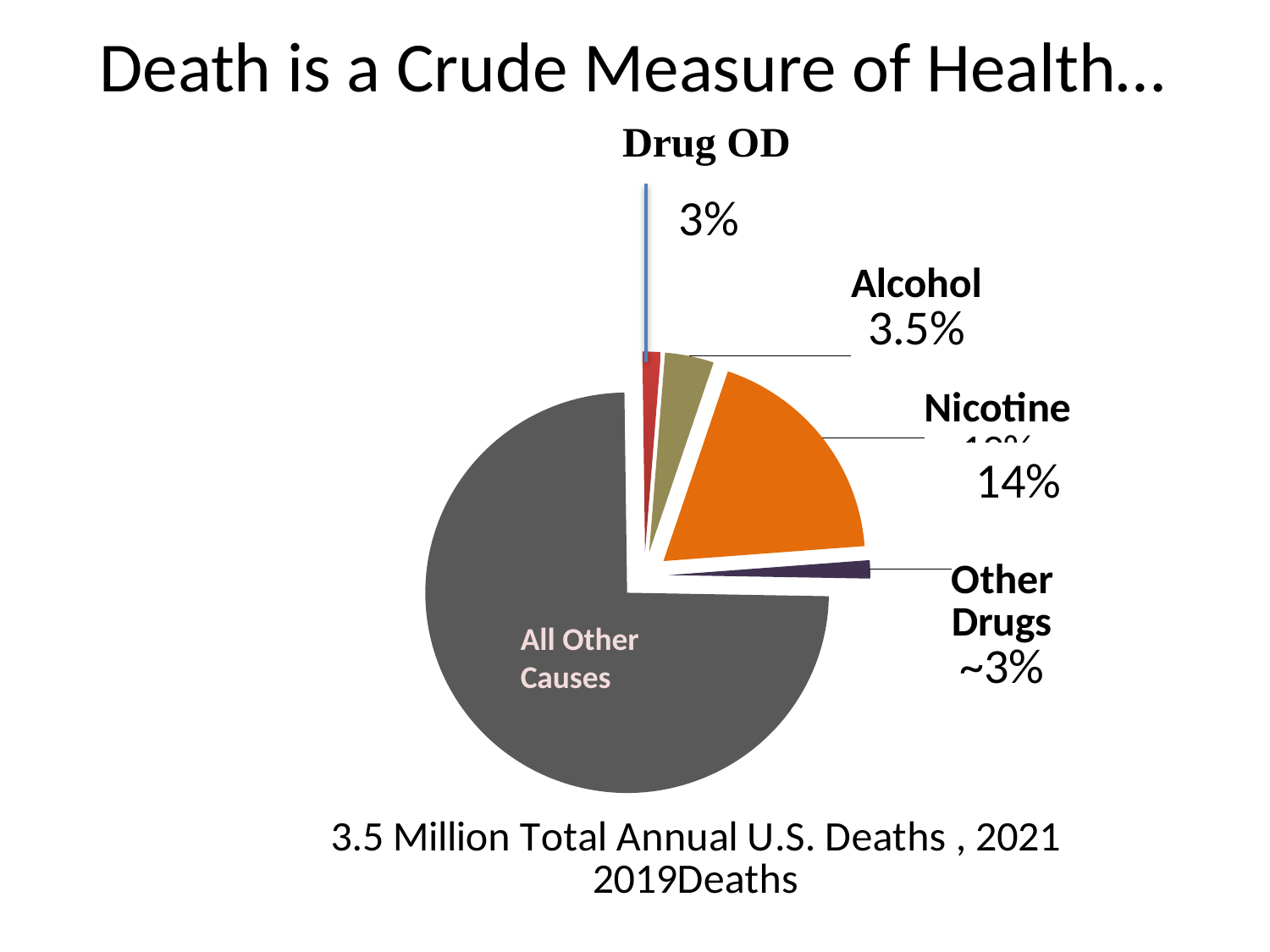
How many percentage points larger is the Nicotine share than the Alcohol share? 10.5% What kind of chart is shown on the slide? pie chart Which is larger in the pie chart, the Alcohol share or the Drug OD share? Alcohol Which is larger in the pie chart, the Nicotine share or the Alcohol share? Nicotine What percentage of deaths is attributed to Alcohol in the pie chart? 3.5% What is the title of the slide containing the pie chart? Death is a Crude Measure of Health… What percentage of deaths is attributed to Nicotine in the pie chart? 14% According to the caption below the pie chart, how many total annual U.S. deaths were there in 2021? 3.5 Million Which slice of the pie chart is the largest? All Other Causes How many percentage points larger is the Alcohol share than the Drug OD share? 0.5% What percentage of deaths is attributed to Drug OD in the pie chart? 3% How many slices does the pie chart have? 5